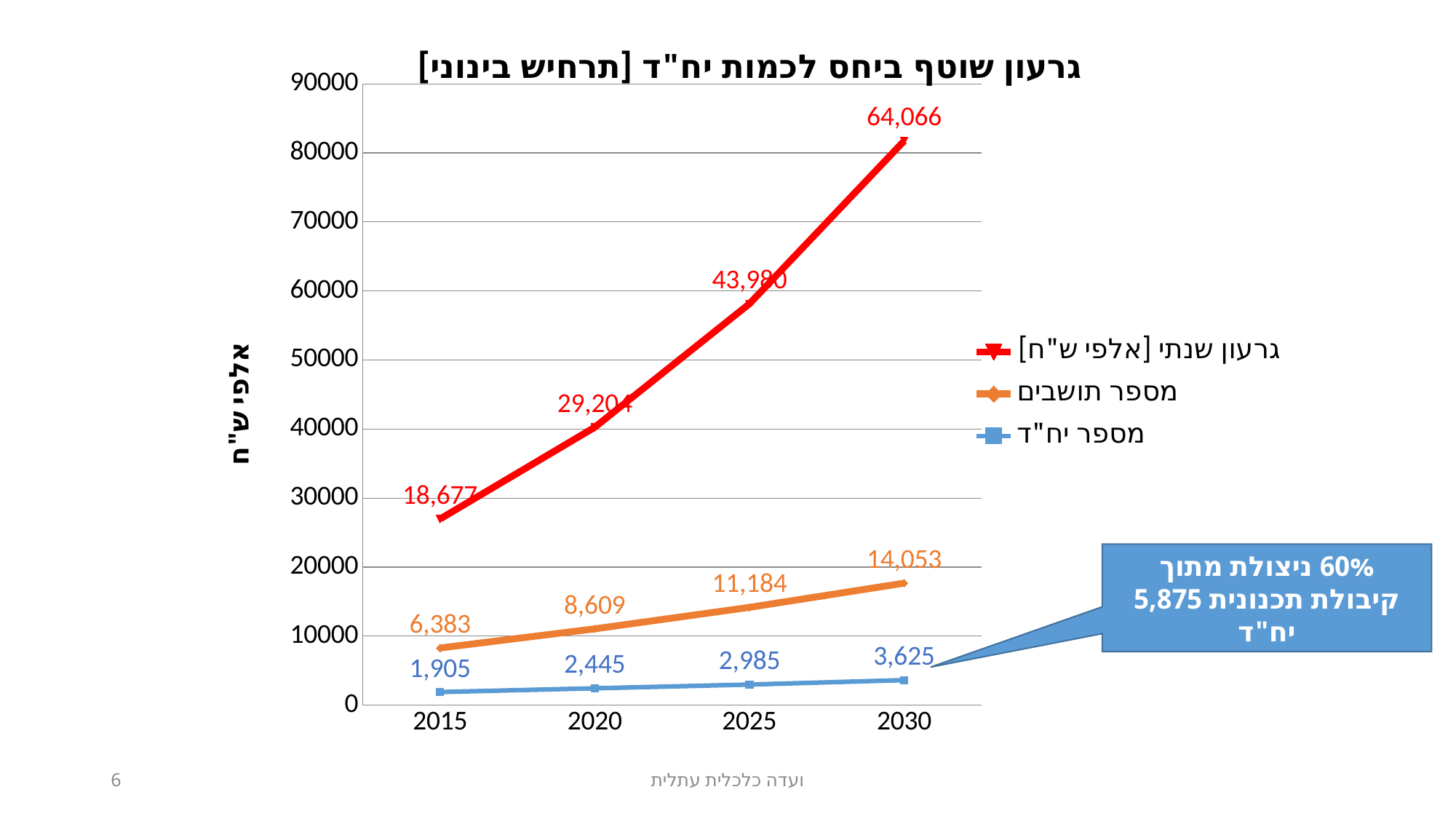
What is the difference between the מספר יח"ד values in 2030 and 2015? 1,720 In which year is מספר תושבים highest? 2030 How many series does the legend list? 3 Does גרעון שנתי [אלפי ש"ח] rise or fall from 2015 to 2030? rise In which year is מספר יח"ד lowest? 2015 Which is larger in 2025: מספר תושבים or מספר יח"ד? מספר תושבים What type of chart is shown on the slide? line chart What is the value of מספר תושבים in 2020? 8,609 What is the value of מספר יח"ד in 2025? 2,985 What is the value of גרעון שנתי [אלפי ש"ח] in 2015? 18,677 What is the value of גרעון שנתי [אלפי ש"ח] in 2030? 64,066 How many years are shown on the x axis? 4